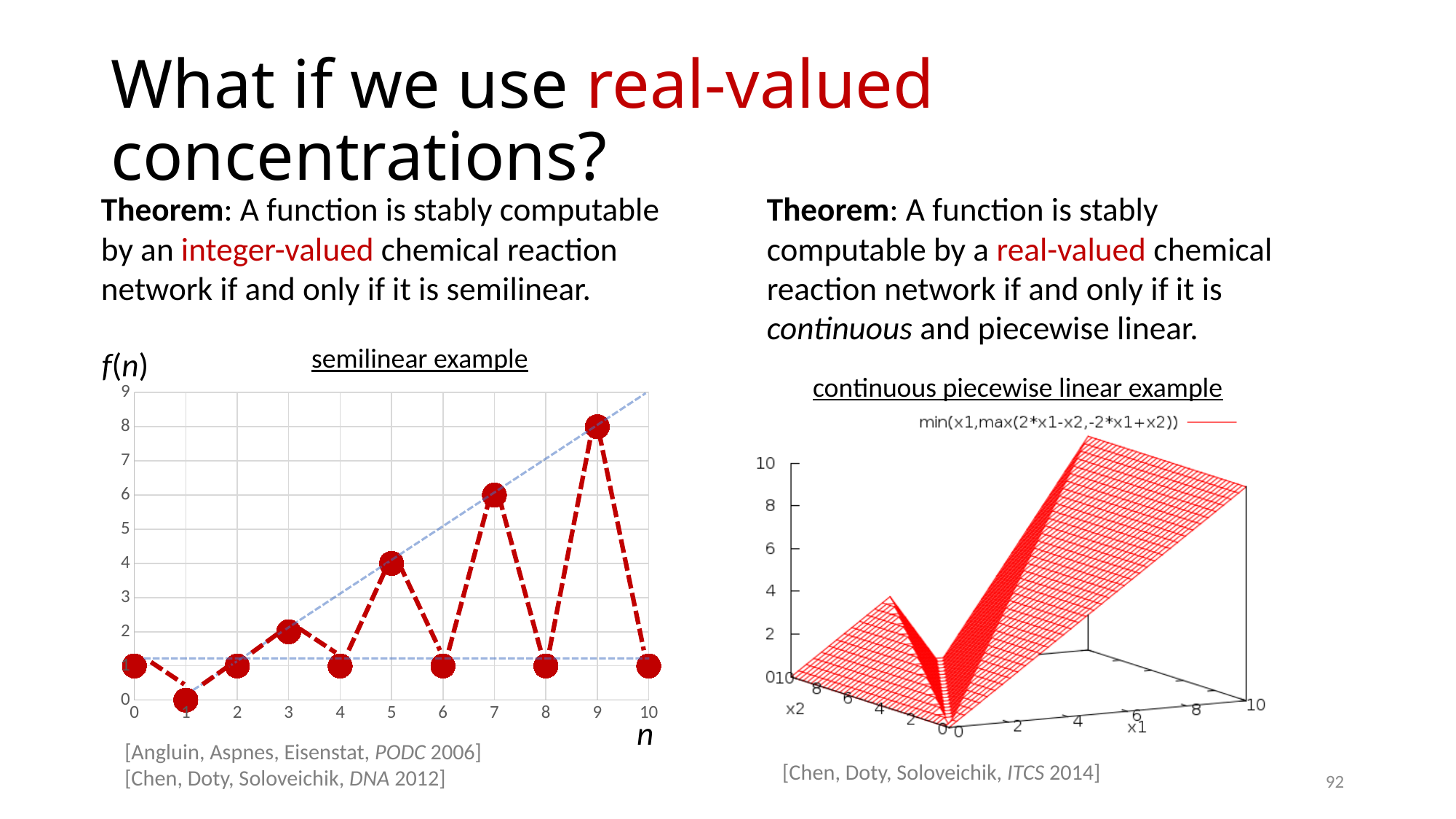
In the 'semilinear example' chart, what is the value of f(n) at n = 9? 8 What kind of chart is the 'continuous piecewise linear example' chart? 3D surface plot In the 'semilinear example' chart, what is the value of f(n) at n = 7? 6 In the 'semilinear example' chart, how many data points are plotted? 11 In the 'semilinear example' chart, at which value of n is f(n) highest? 9 In the 'continuous piecewise linear example' chart, what function is named in the legend? min(x1,max(2*x1-x2,-2*x1+x2)) What kind of chart is the 'semilinear example' chart? Line chart In the 'semilinear example' chart, what is the difference between f(9) and f(7)? 2 In the 'semilinear example' chart, which is larger, f(3) or f(5)? f(5) In the 'semilinear example' chart, at which value of n is f(n) lowest? 1 In the 'semilinear example' chart, what is the value of f(n) at n = 1? 0 In the 'semilinear example' chart, what is the value of f(n) at n = 5? 4